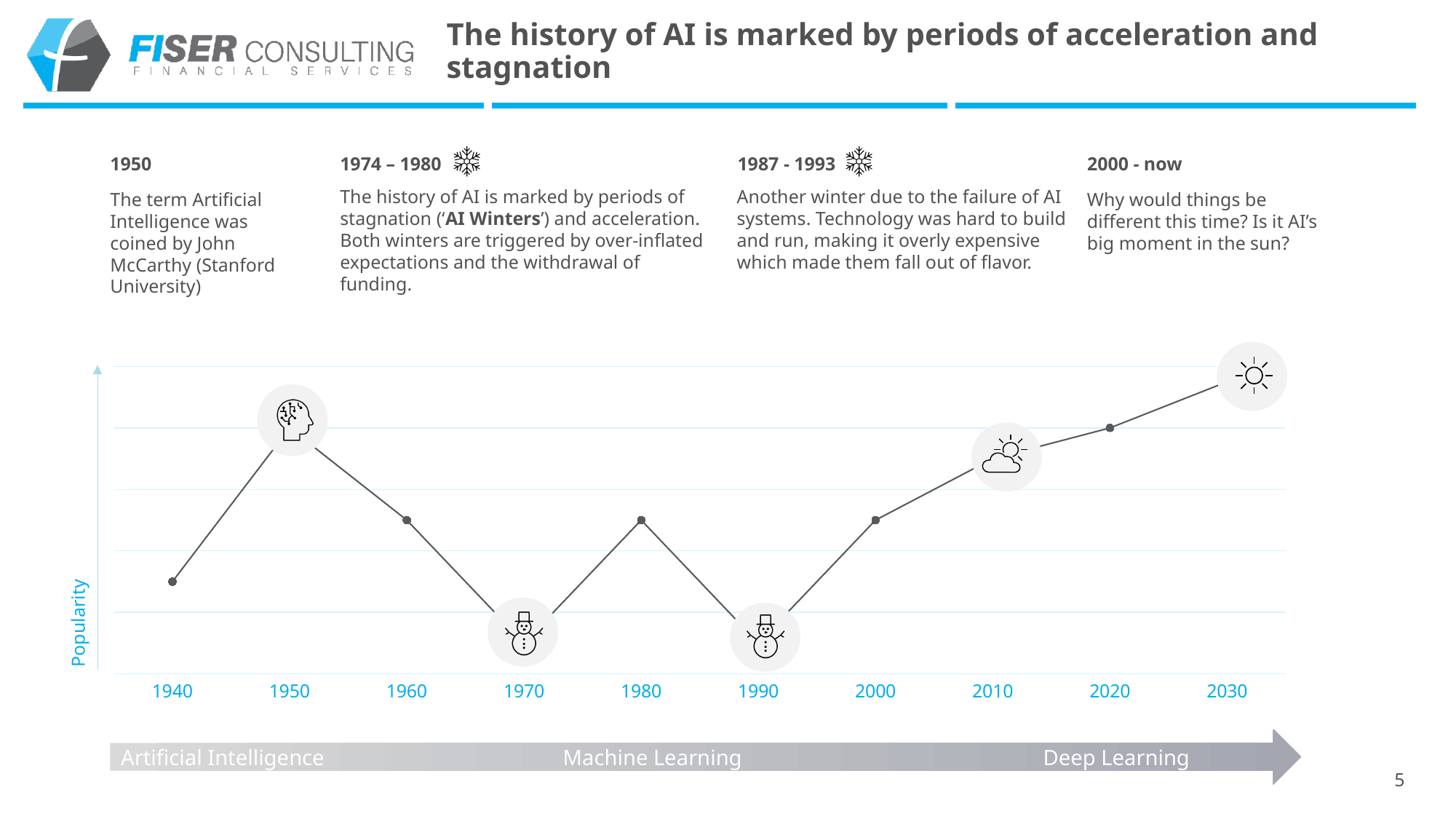
What kind of chart is shown on the slide? line chart Which is higher on the chart, the value for 2010 or the value for 2020? 2020 How many data points are plotted on the line chart? 10 Which is higher on the chart, the value for 1940 or the value for 1960? 1960 What is the label on the vertical axis of the chart? Popularity Which year on the x axis has the highest popularity value? 2030 Which is higher on the chart, the value for 1970 or the value for 1980? 1980 Do the values rise or fall along the x axis from 1950 to 1970? fall Do the values rise or fall along the x axis from 1990 to 2030? rise What is the first year shown on the x axis of the chart? 1940